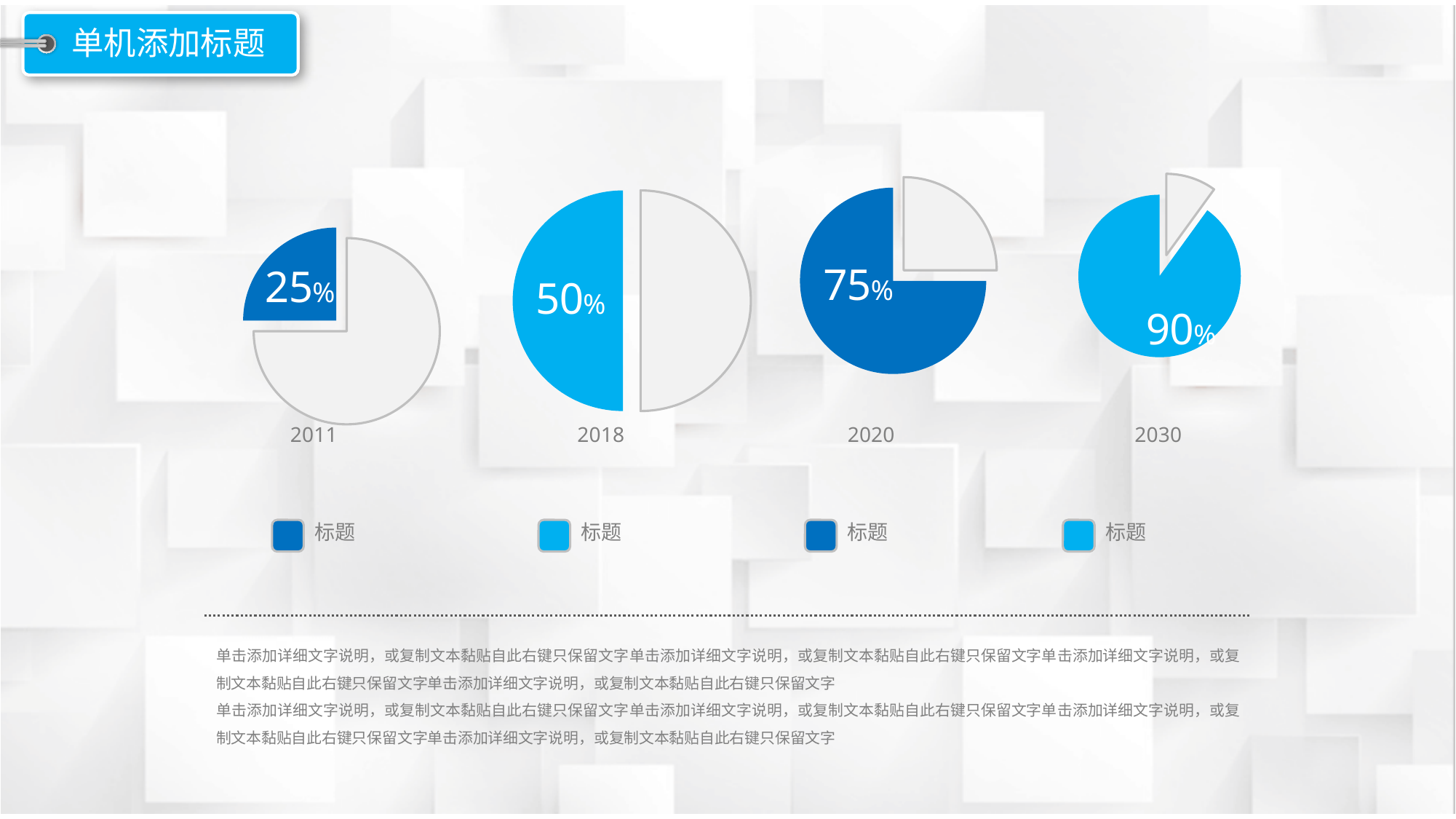
What is the difference between the percentage on the 2030 pie chart and the percentage on the 2011 pie chart? 65% Which of the four pie charts shows the highest percentage? 2030 Which shows a larger percentage, the 2018 pie chart or the 2020 pie chart? 2020 Which of the four pie charts shows the lowest percentage? 2011 What percentage is shown on the pie chart labelled 2011? 25% What percentage is shown on the pie chart labelled 2030? 90% What kind of chart is used for the 2011 figure? Pie chart Do the percentages rise or fall from the 2011 chart to the 2030 chart? Rise How many pie charts are shown on the slide? 4 What percentage is shown on the pie chart labelled 2020? 75% What is the difference between the percentage on the 2020 pie chart and the percentage on the 2018 pie chart? 25% What percentage is shown on the pie chart labelled 2018? 50%